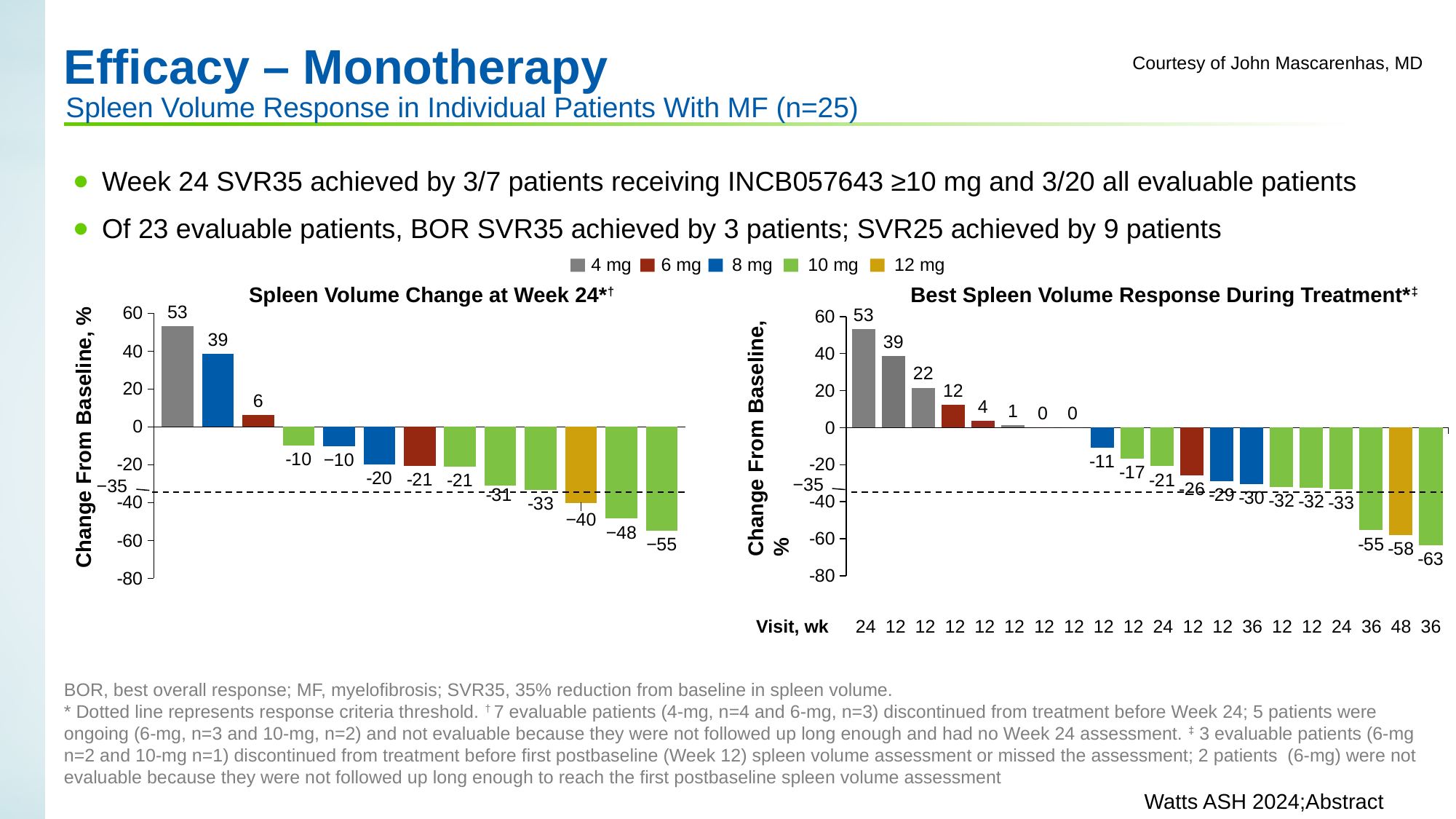
At what value is the dotted response-criteria threshold line drawn in both charts? −35 In the 'Spleen Volume Change at Week 24' chart, what is the difference between the highest and lowest values? 108 In the 'Best Spleen Volume Response During Treatment' chart, what is the value of the 12 mg (gold) bar? -58 How many bars are plotted in the 'Spleen Volume Change at Week 24' chart? 13 How many bars are plotted in the 'Best Spleen Volume Response During Treatment' chart? 20 In the 'Best Spleen Volume Response During Treatment' chart, which is larger: the first bar or the third bar? the first bar (53) What kind of chart is the 'Spleen Volume Change at Week 24' chart? bar chart In the 'Spleen Volume Change at Week 24' chart, what is the lowest value shown? −55 In the 'Spleen Volume Change at Week 24' chart, what is the highest value shown? 53 How many dose groups does the legend list? 5 In the 'Spleen Volume Change at Week 24' chart, what is the value of the 12 mg (gold) bar? −40 In the 'Best Spleen Volume Response During Treatment' chart, what is the lowest value shown? -63